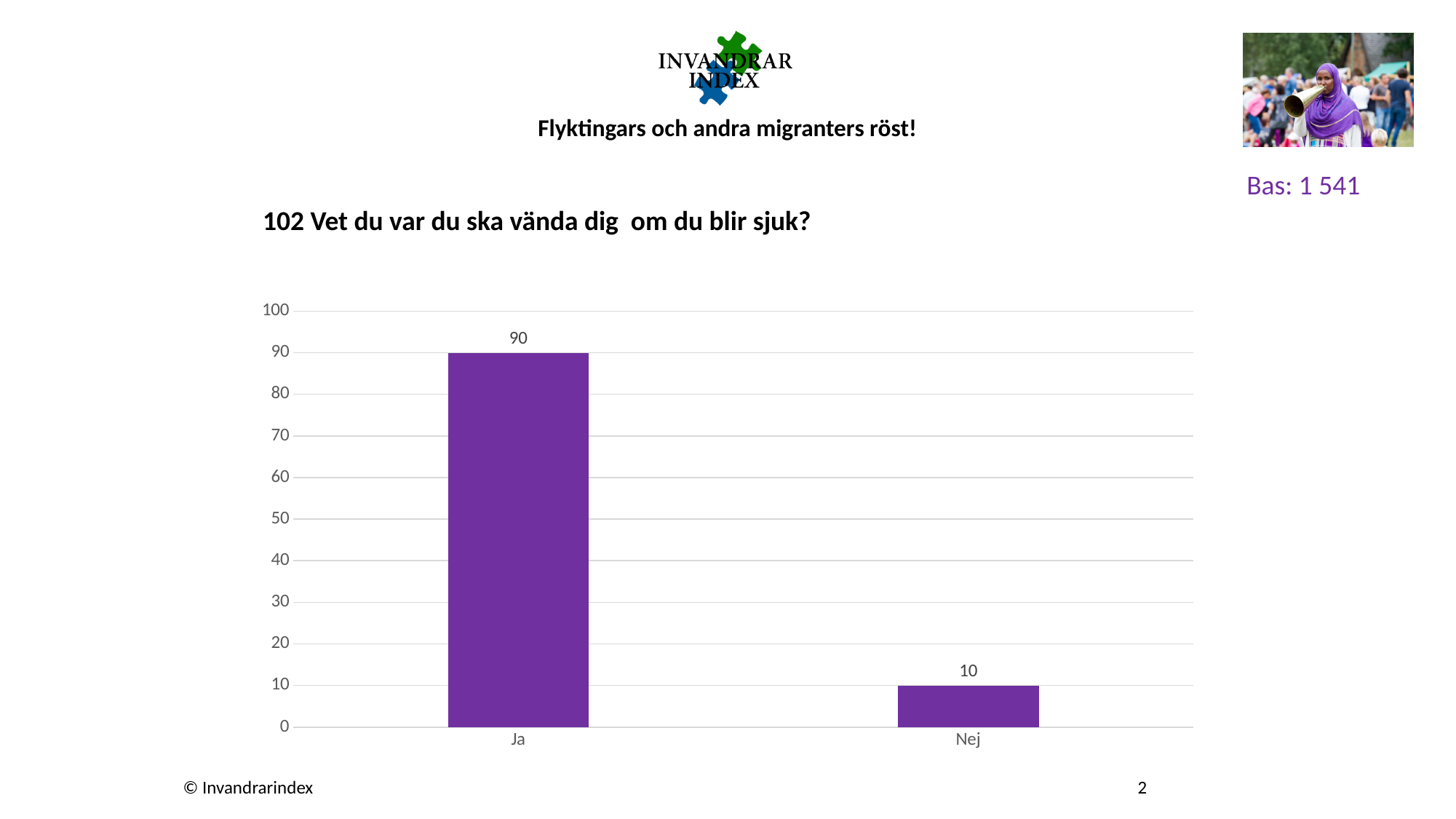
How many categories are shown on the x axis? 2 Which category has the lowest value? Nej Which category has the highest value? Ja Which is larger, the value for Ja or the value for Nej? Ja Is the value for Ja greater or less than 50? greater What is the title of the chart? 102 Vet du var du ska vända dig om du blir sjuk? What is the difference between the values for Ja and Nej? 80 What is the value for Ja? 90 What is the value for Nej? 10 What is the maximum value shown on the y axis? 100 What kind of chart is shown on the slide? bar chart Is the value for Nej greater or less than 20? less